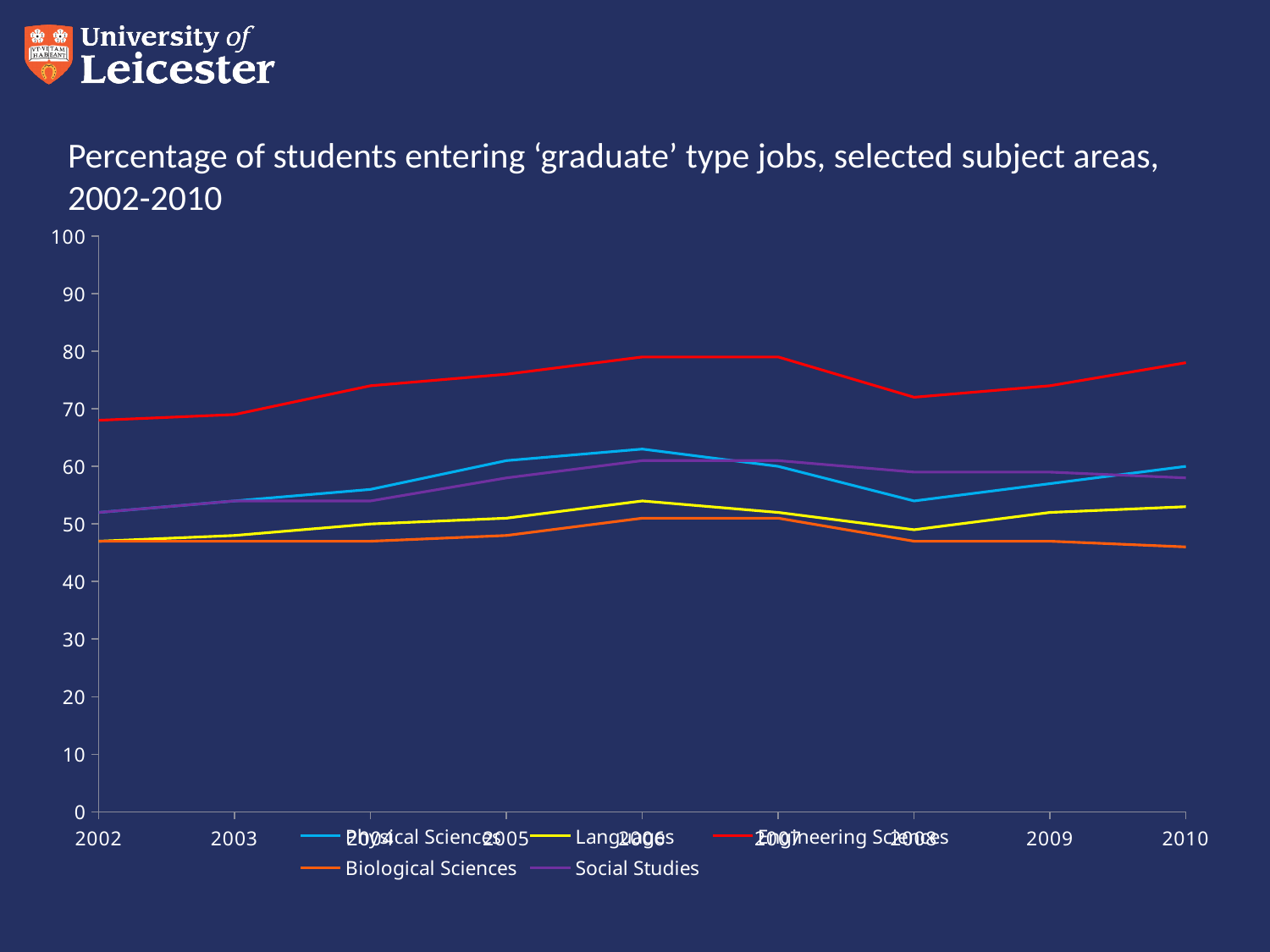
Is the value for Engineering Sciences in 2006 greater or less than 70? greater How many series does the legend list? 5 Which subject area has the highest percentage in 2010? Engineering Sciences In 2008, which is larger: Physical Sciences or Social Studies? Social Studies Is the value for Biological Sciences in 2002 greater or less than 50? less How many years are plotted along the x axis? 9 Which subject area has the lowest percentage in 2010? Biological Sciences Is the value for Languages in 2006 greater or less than 50? greater Does the Engineering Sciences line rise or fall from 2002 to 2006? rise Does the Biological Sciences line rise or fall from 2007 to 2010? fall What colour is the Engineering Sciences line? red What kind of chart is shown on the slide? line chart